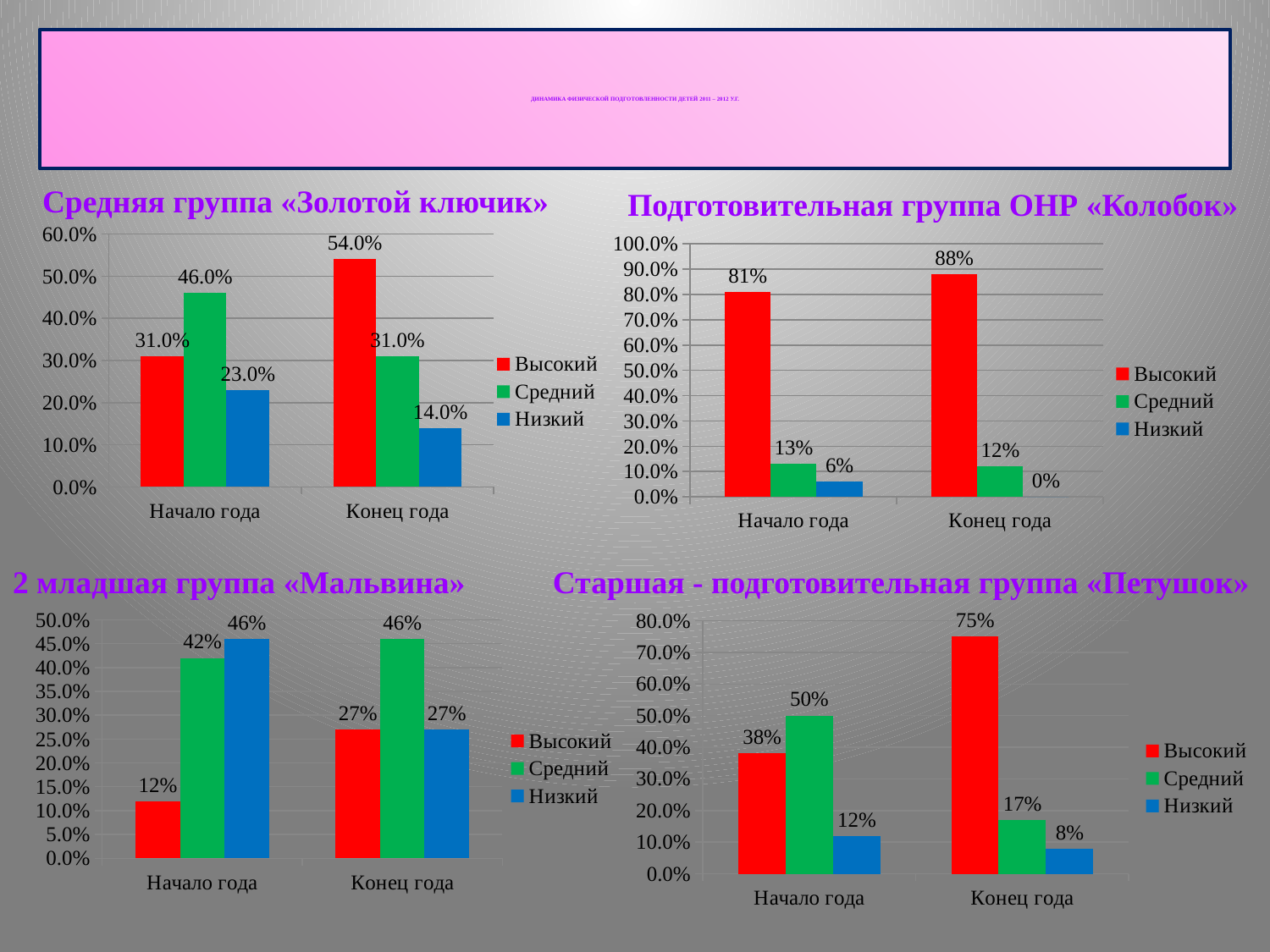
In the chart titled «Петушок», which is larger at Начало года: Высокий or Средний? Средний In the chart titled «Золотой ключик», what is the value for Высокий at Конец года? 54.0% In the chart titled «Мальвина», what is the value for Средний at Конец года? 46% In the chart titled «Золотой ключик», what is the difference between the Высокий values at Конец года and Начало года? 23.0% How many series does the legend list in the chart titled «Петушок»? 3 In the chart titled «Золотой ключик», what is the value for Низкий at Начало года? 23.0% In the chart titled «Мальвина», which series has the lowest value at Начало года? Высокий In the chart titled «Колобок», is the value for Высокий at Конец года greater or less than 80.0%? greater In the chart titled «Колобок», which series has the highest value at Начало года? Высокий In the chart titled «Петушок», what is the value for Высокий at Конец года? 75% What type of chart is the chart titled «Мальвина»? Bar chart In the chart titled «Колобок», what is the value for Низкий at Конец года? 0%